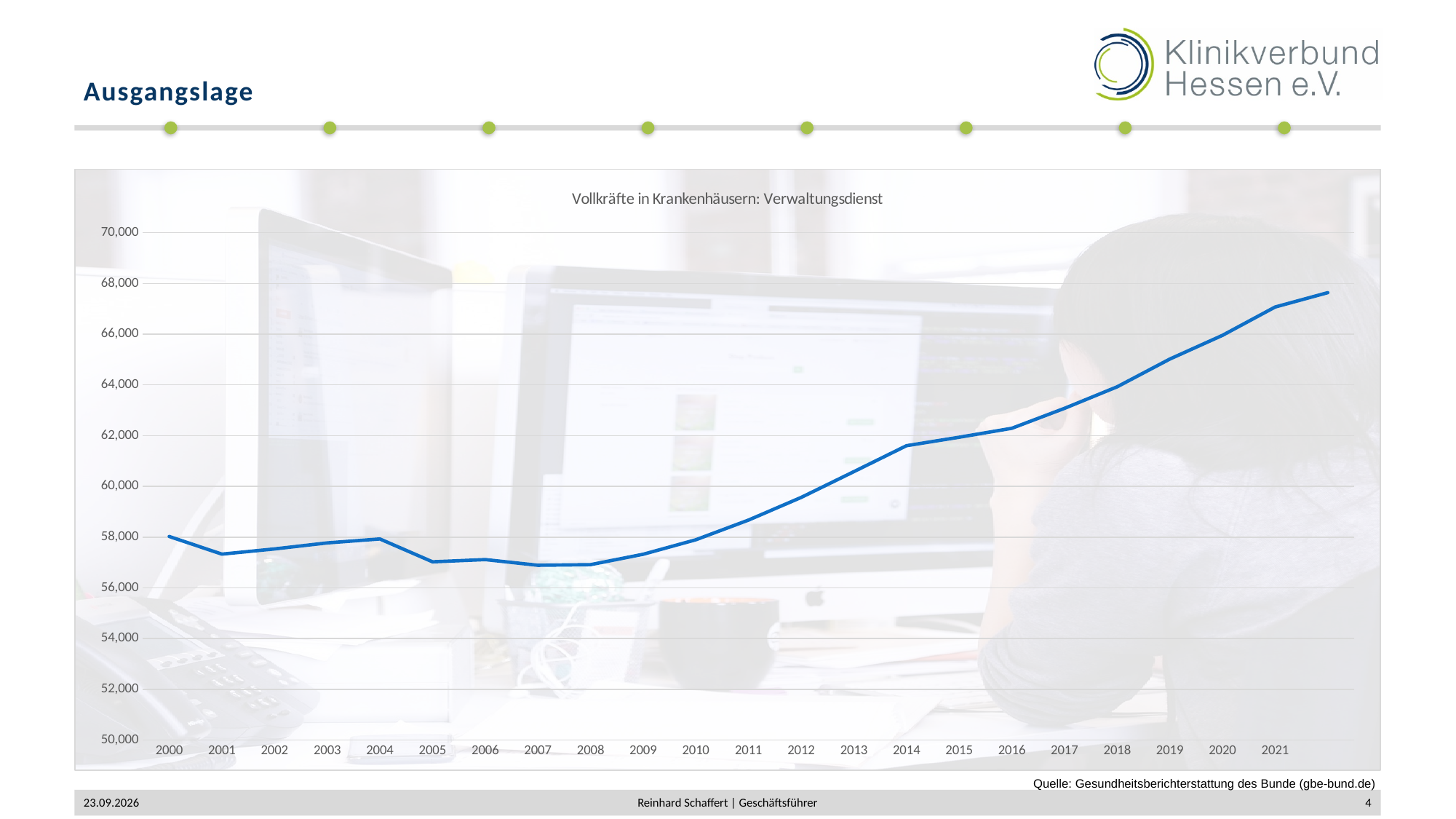
What kind of chart is shown on the slide? line chart Is the value for 2016 greater or less than 62,000? greater Is the value for 2021 greater or less than 66,000? greater Is the value for 2007 greater or less than 56,000? greater What is the first year labelled on the x axis? 2000 What is the title of the chart? Vollkräfte in Krankenhäusern: Verwaltungsdienst Which year has the larger value, 2000 or 2021? 2021 Does the line generally rise or fall between 2008 and 2021? rise